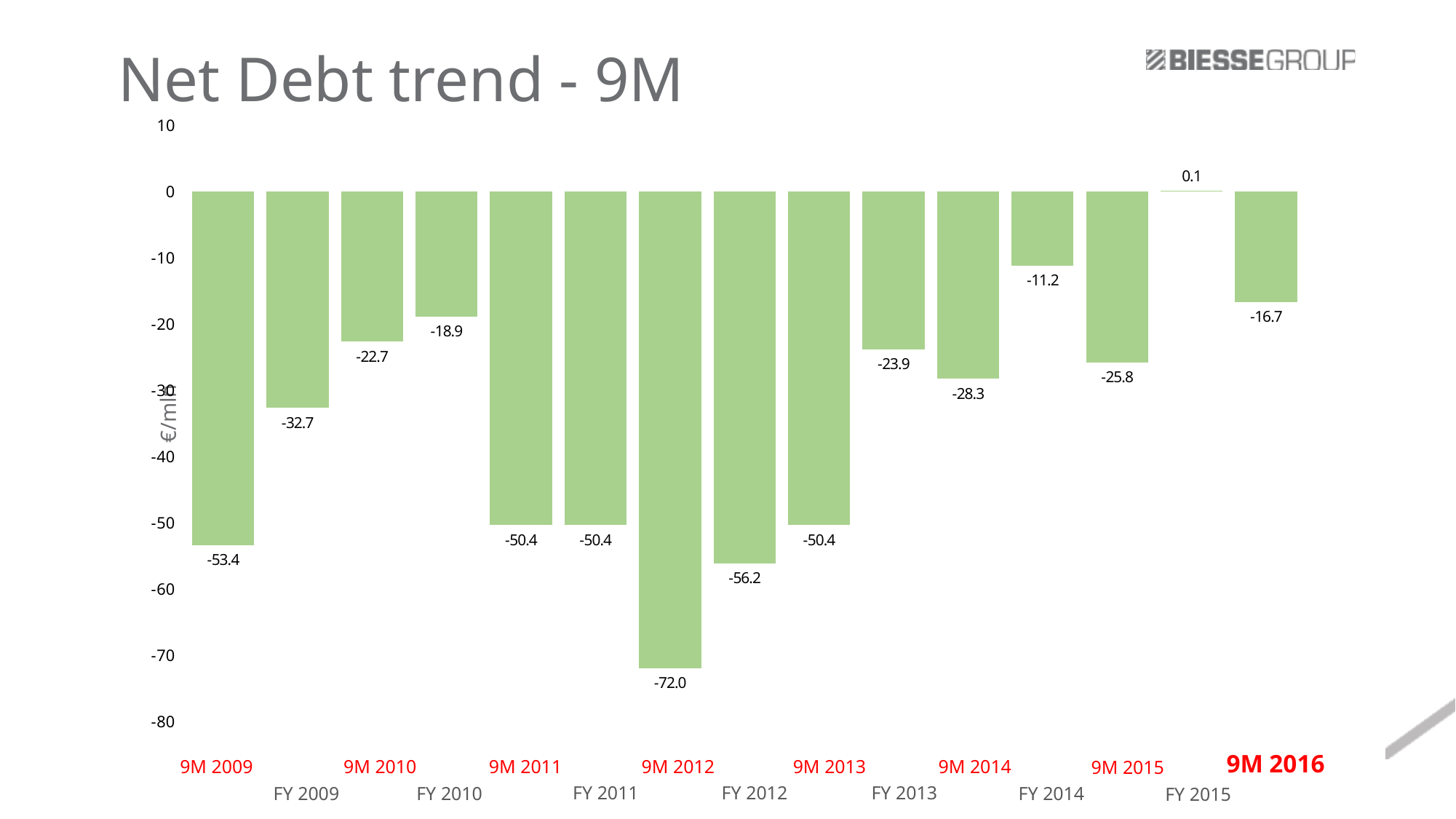
Which period has the highest net debt value? FY 2015 What type of chart is shown on the slide? Bar chart Which is larger, the net debt value for 9M 2009 or for FY 2009? FY 2009 How many bars are plotted in the chart? 15 What is the net debt value for FY 2014? -11.2 What is the net debt value for 9M 2016? -16.7 What is the net debt value for 9M 2012? -72.0 Which period has the lowest (most negative) net debt value? 9M 2012 What is the difference between the net debt values for 9M 2015 and 9M 2016? 9.1 What unit is shown on the vertical axis label? €/mln What is the net debt value for FY 2015? 0.1 What is the title of the chart on the slide? Net Debt trend - 9M